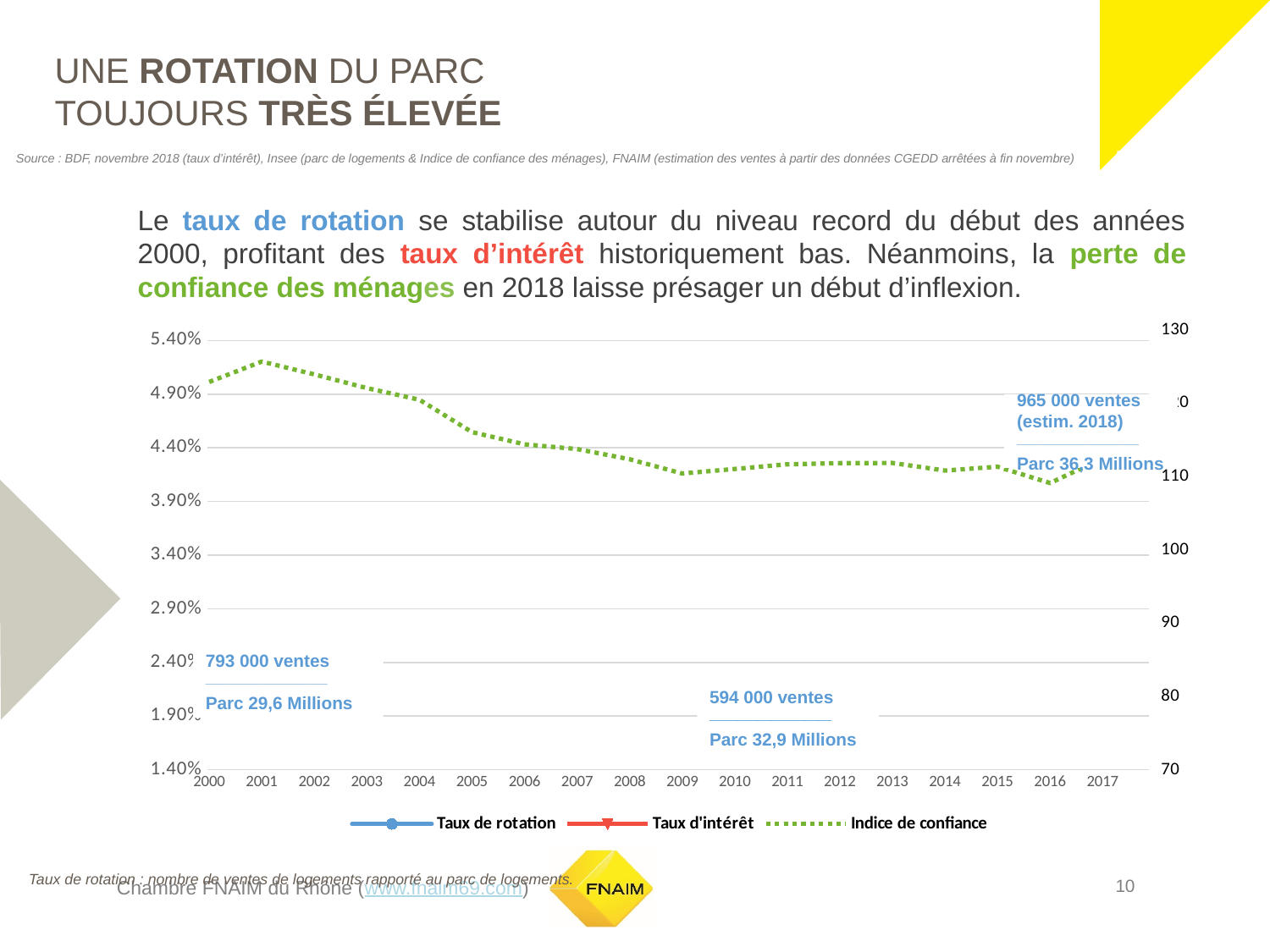
What is the first year shown on the x axis of the chart? 2000 How many series does the chart legend list? 3 In which year does the Indice de confiance line reach its highest point? 2001 Is the Indice de confiance higher in 2001 or in 2016? 2001 According to the annotation on the chart, how many sales (ventes) are estimated for 2018? 965 000 ventes How many years are shown on the x axis of the chart? 18 Does the Indice de confiance line rise or fall overall from 2000 to 2017? fall What is the last year shown on the x axis of the chart? 2017 According to the annotation on the chart, how many sales (ventes) are indicated around 2009-2010? 594 000 ventes Is the Indice de confiance in 2009 greater or less than 100 on the right axis? greater According to the annotation on the chart, what is the size of the housing stock (Parc) at the start of the period, near 2000? Parc 29,6 Millions What kind of chart is shown on the slide? line chart